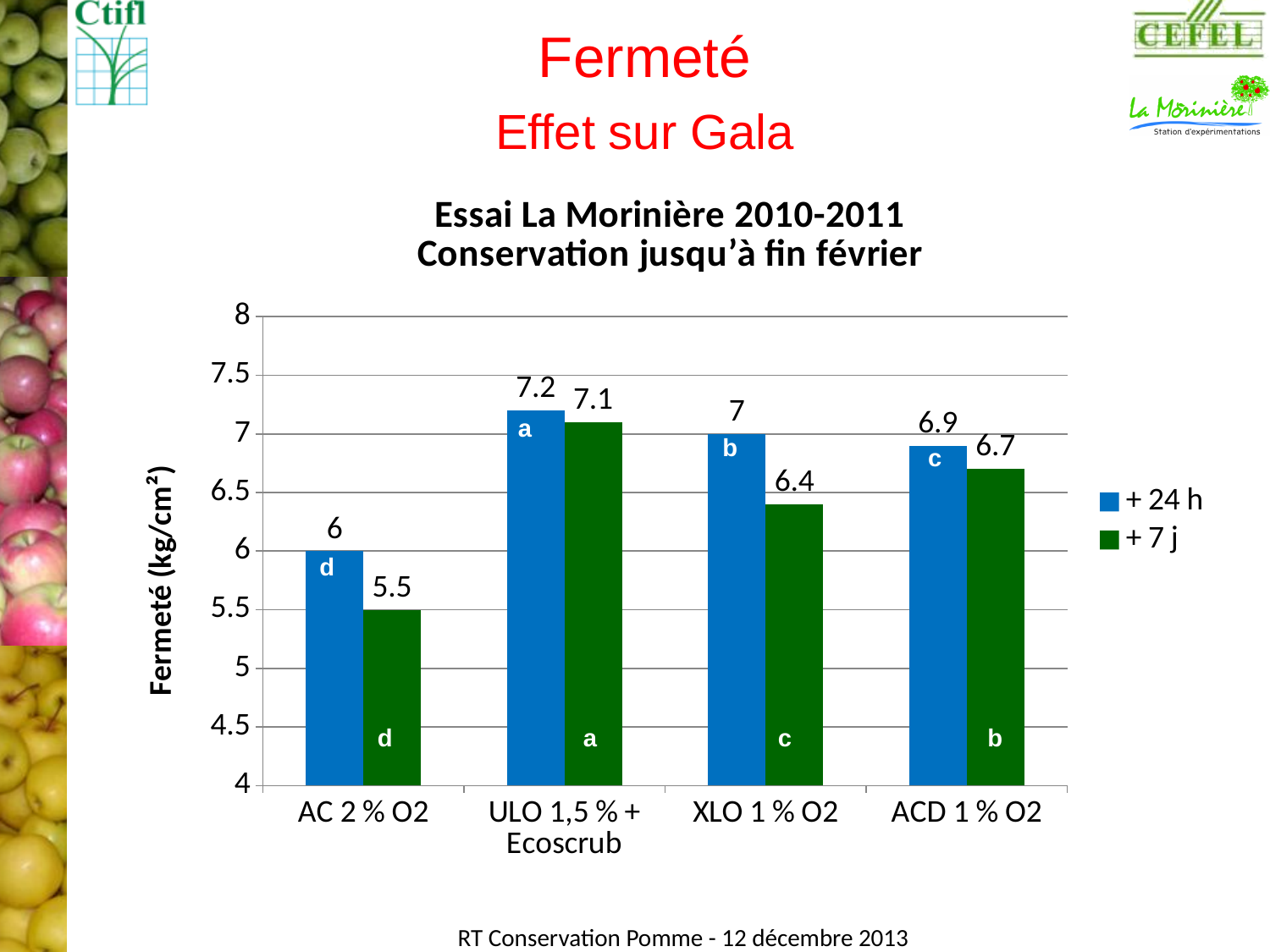
How many categories are shown on the x axis? 4 Which category has the lowest value in the + 7 j series? AC 2 % O2 What is the value for ULO 1,5 % + Ecoscrub in the + 7 j series? 7.1 Which category has the highest value in the + 24 h series? ULO 1,5 % + Ecoscrub What is the label of the y axis? Fermeté (kg/cm²) What is the value for XLO 1 % O2 in the + 7 j series? 6.4 Which is larger: the + 7 j value for ACD 1 % O2 or the + 7 j value for XLO 1 % O2? ACD 1 % O2 What is the value for ACD 1 % O2 in the + 24 h series? 6.9 What is the value for AC 2 % O2 in the + 24 h series? 6 What kind of chart is shown on the slide? Bar chart What is the difference between the + 24 h and + 7 j values for XLO 1 % O2? 0.6 How many series does the legend list? 2